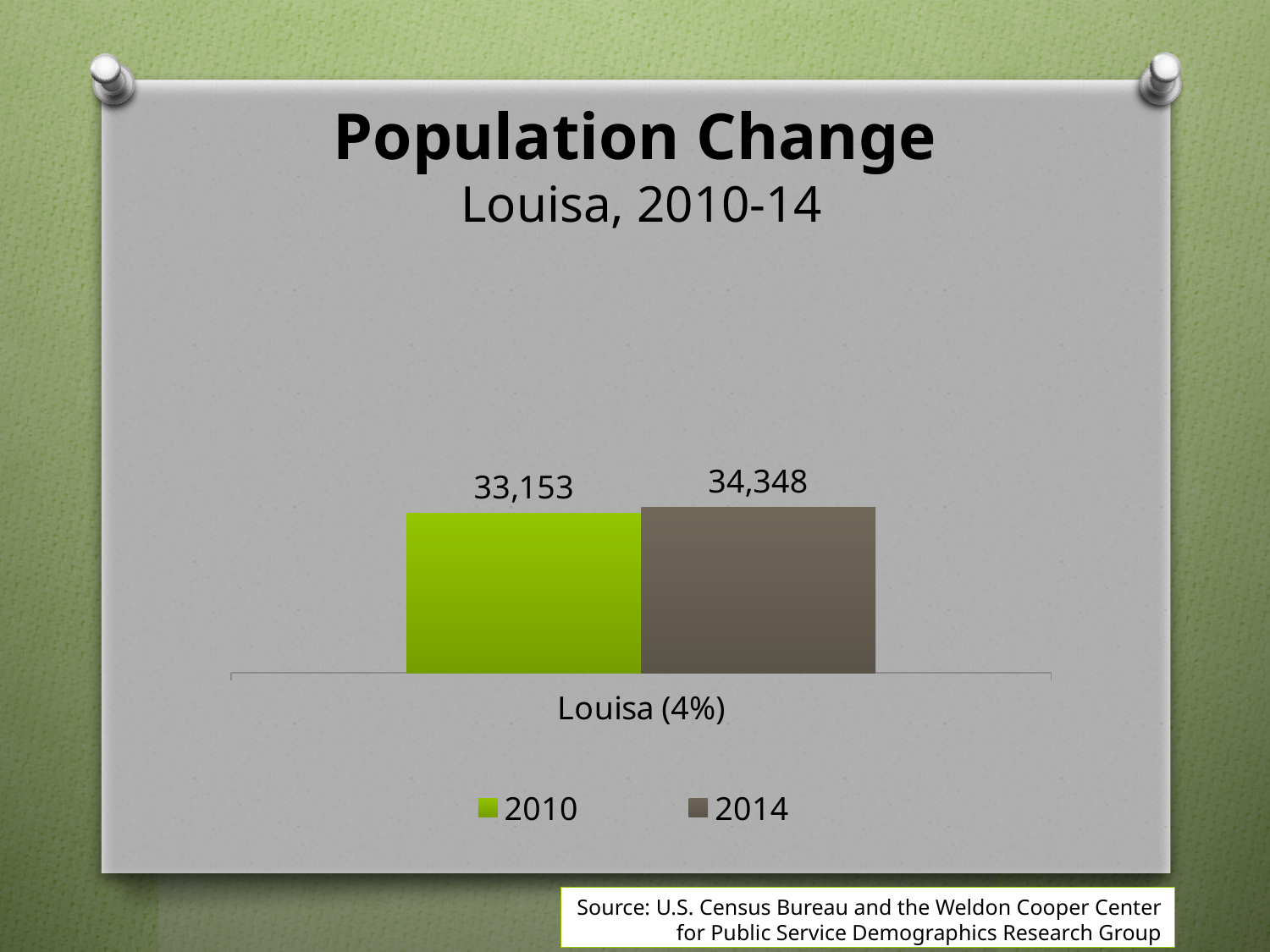
Did the population of Louisa rise or fall from 2010 to 2014? rise What is the value for 2010 in the Louisa (4%) category? 33,153 How many series does the legend list? 2 Which series has the higher value, 2010 or 2014? 2014 What is the difference between the 2014 and 2010 values? 1,195 What kind of chart is shown on the slide? bar chart Which series has the lowest value? 2010 How many categories are shown on the x axis? 1 Which series is shown in green? 2010 What is the value for 2014 in the Louisa (4%) category? 34,348 What is the label of the category on the x axis? Louisa (4%)